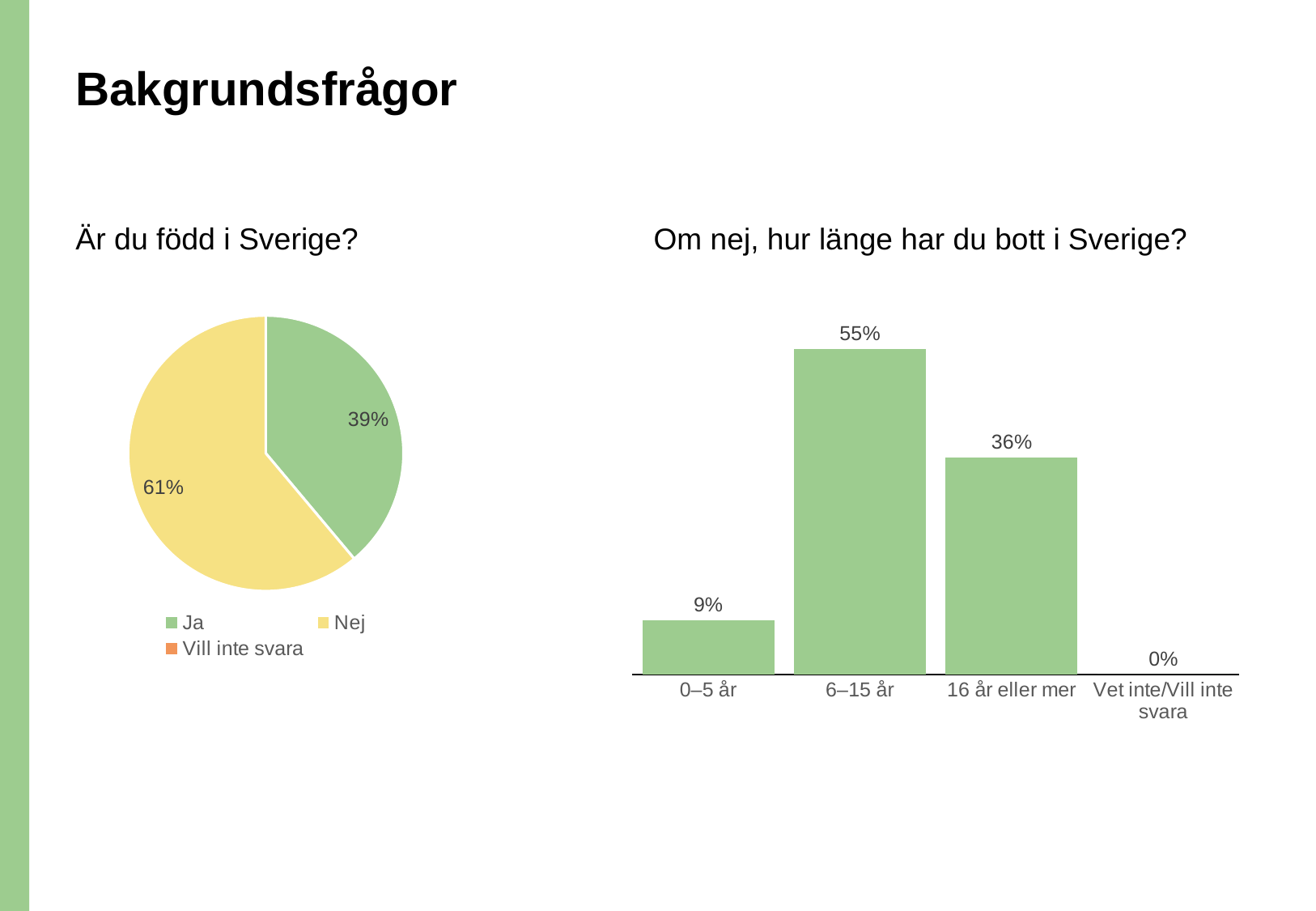
In the pie chart 'Är du född i Sverige?', what is the difference between the 'Nej' and 'Ja' shares? 22% In the bar chart 'Om nej, hur länge har du bott i Sverige?', which category has the lowest value? Vet inte/Vill inte svara In the bar chart 'Om nej, hur länge har du bott i Sverige?', what is the difference between '6–15 år' and '16 år eller mer'? 19% In the bar chart 'Om nej, hur länge har du bott i Sverige?', how many categories are shown on the x axis? 4 In the pie chart 'Är du född i Sverige?', how many entries does the legend list? 3 In the bar chart 'Om nej, hur länge har du bott i Sverige?', what is the value for '6–15 år'? 55% In the bar chart 'Om nej, hur länge har du bott i Sverige?', which category has the highest value? 6–15 år In the bar chart 'Om nej, hur länge har du bott i Sverige?', what is the value for '0–5 år'? 9% In the pie chart 'Är du född i Sverige?', what share of respondents answered 'Nej'? 61% In the pie chart 'Är du född i Sverige?', what share of respondents answered 'Ja'? 39% In the pie chart 'Är du född i Sverige?', which answer has the largest slice? Nej What kind of chart is used for 'Om nej, hur länge har du bott i Sverige?'? Bar chart